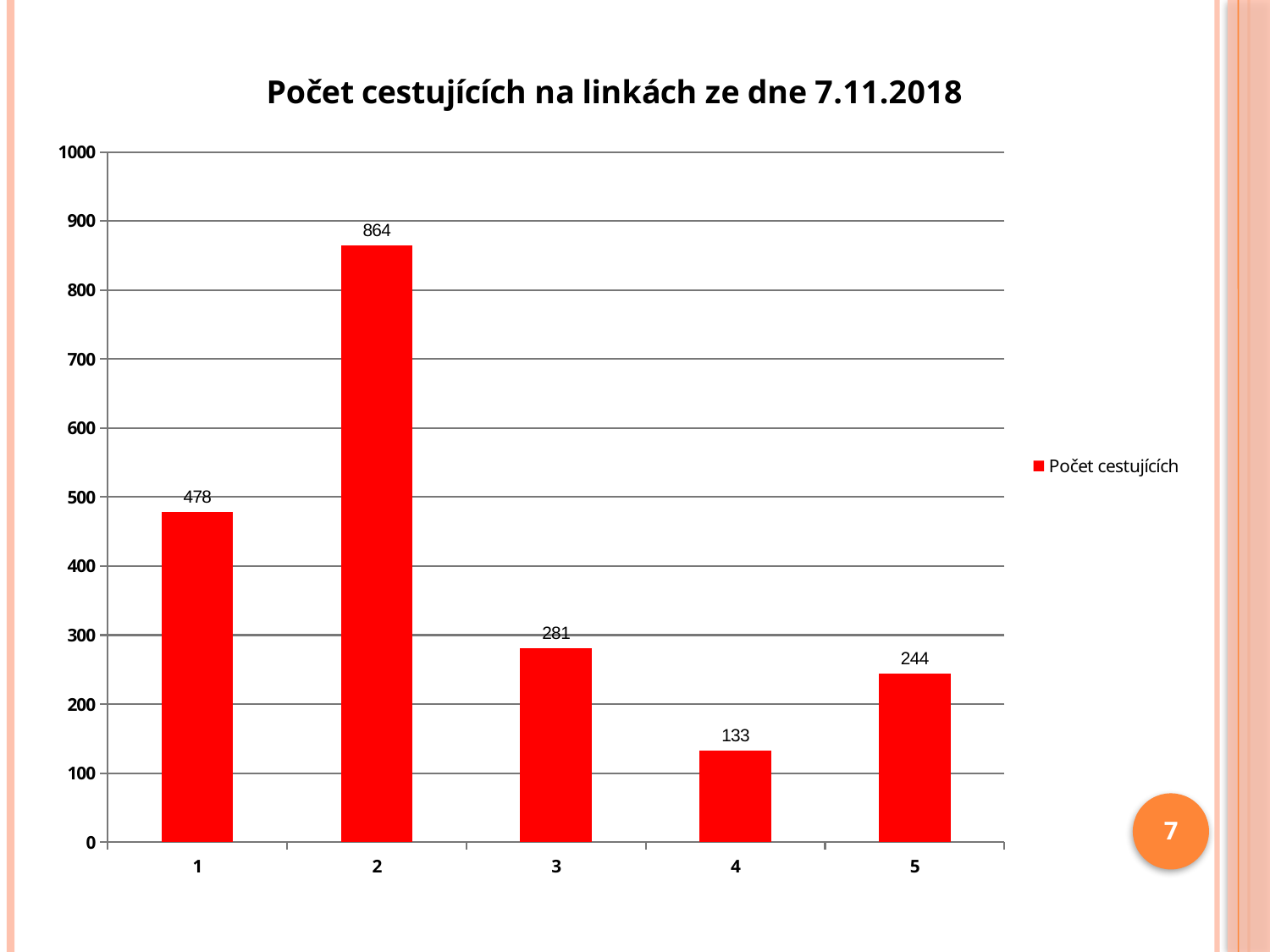
What is the difference between the values for category 3 and category 5? 37 Which is larger, the value for category 1 or the value for category 3? 1 Is the value for category 1 greater or less than 400? greater What is the value for category 2? 864 What kind of chart is shown on the slide? bar chart What is the difference between the values for category 2 and category 1? 386 How many categories are shown on the x axis? 5 What is the value for category 4? 133 What is the title of the chart? Počet cestujících na linkách ze dne 7.11.2018 Which category has the highest value? 2 What is the value for category 5? 244 Which category has the lowest value? 4